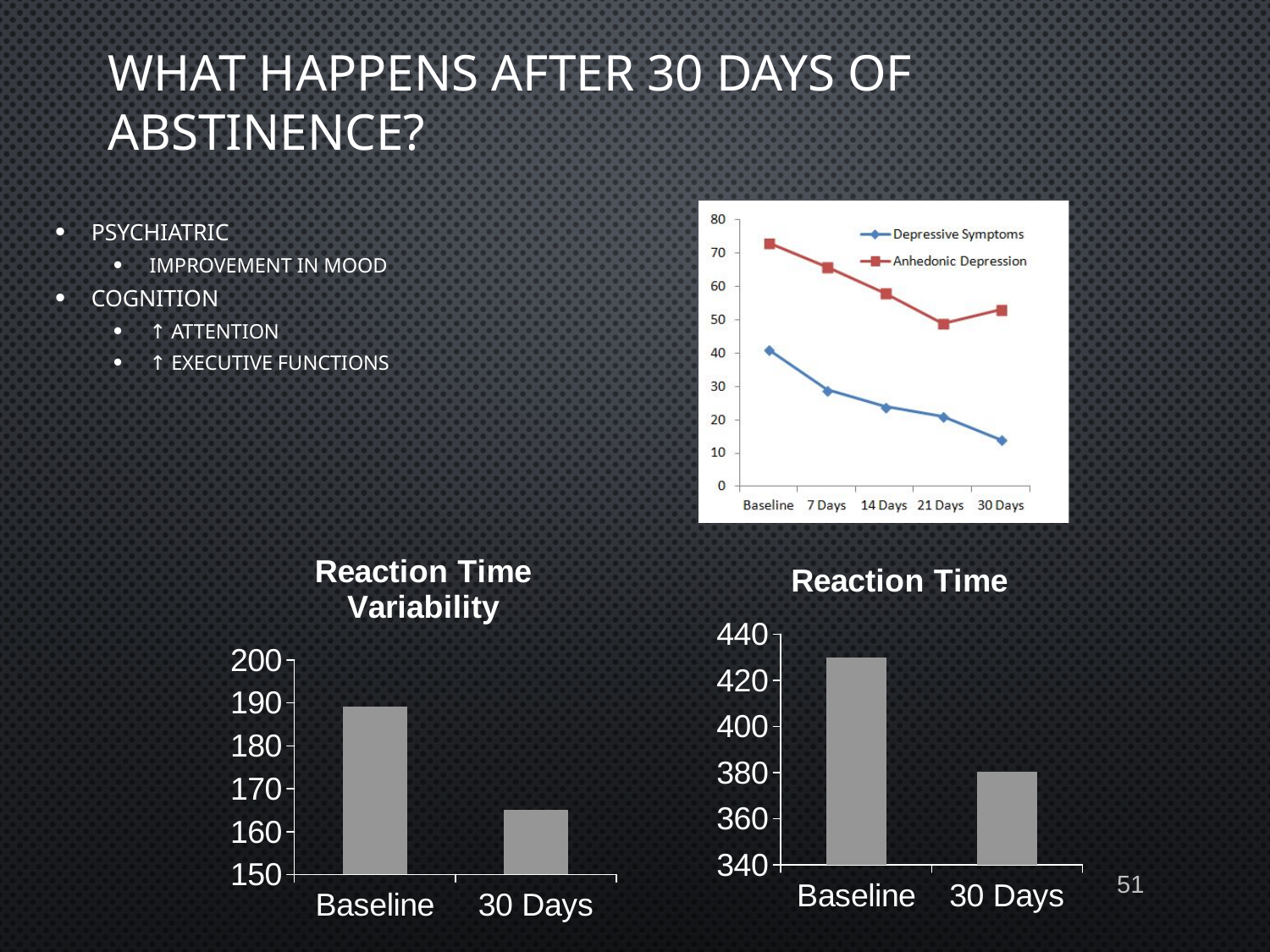
In the top-right line chart, is the Depressive Symptoms value at 30 Days greater or less than 20? less In the Reaction Time Variability chart, is the Baseline value greater or less than 180? greater In the top-right line chart, at which time point is Anhedonic Depression highest? Baseline In the top-right line chart, do the Depressive Symptoms values rise or fall from Baseline to 30 Days? Fall In the top-right line chart, which series has the higher value at 21 Days? Anhedonic Depression In the top-right line chart, how many series does the legend list? 2 In the top-right line chart, is the Anhedonic Depression value at Baseline greater or less than 70? greater What kind of chart is the top-right chart showing Depressive Symptoms and Anhedonic Depression? Line chart In the Reaction Time chart, which is larger, Baseline or 30 Days? Baseline What kind of chart is the Reaction Time Variability chart? Bar chart In the top-right line chart, how many time points are shown on the x axis? 5